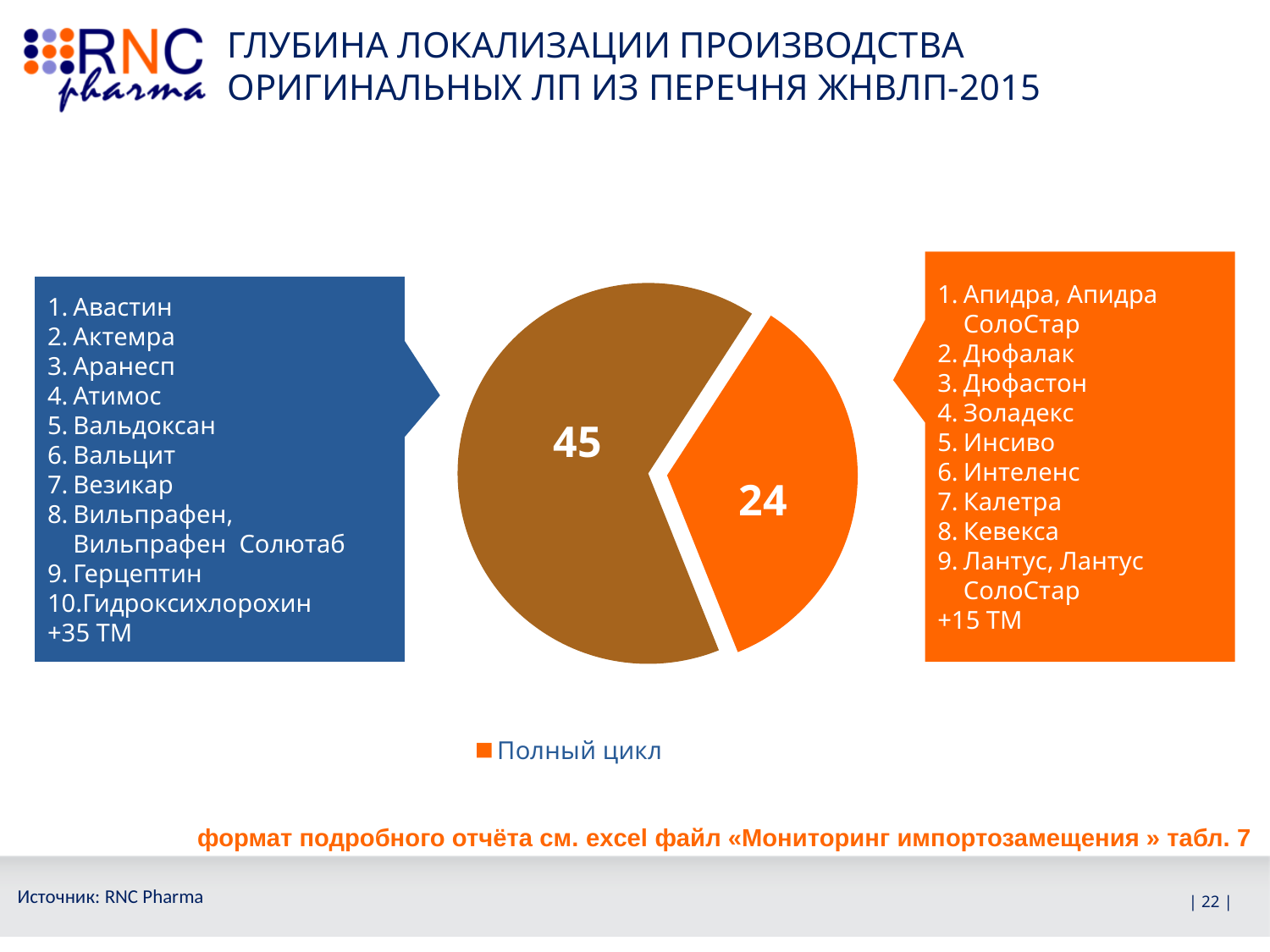
How many entries does the legend of the pie chart list? 1 What is the difference between the two slice values in the pie chart? 21 What is the value of the largest slice in the pie chart? 45 Which slice is larger: the one labelled 45 or the one labelled 24? 45 What is the value of the smallest slice in the pie chart? 24 What is the total of the two slice values shown in the pie chart? 69 How many slices does the pie chart have? 2 What type of chart is shown on the slide? pie chart What is the name of the entry shown in the pie chart's legend? Полный цикл What colour is the "Полный цикл" slice in the pie chart? orange What value is shown for the "Полный цикл" slice of the pie chart? 24